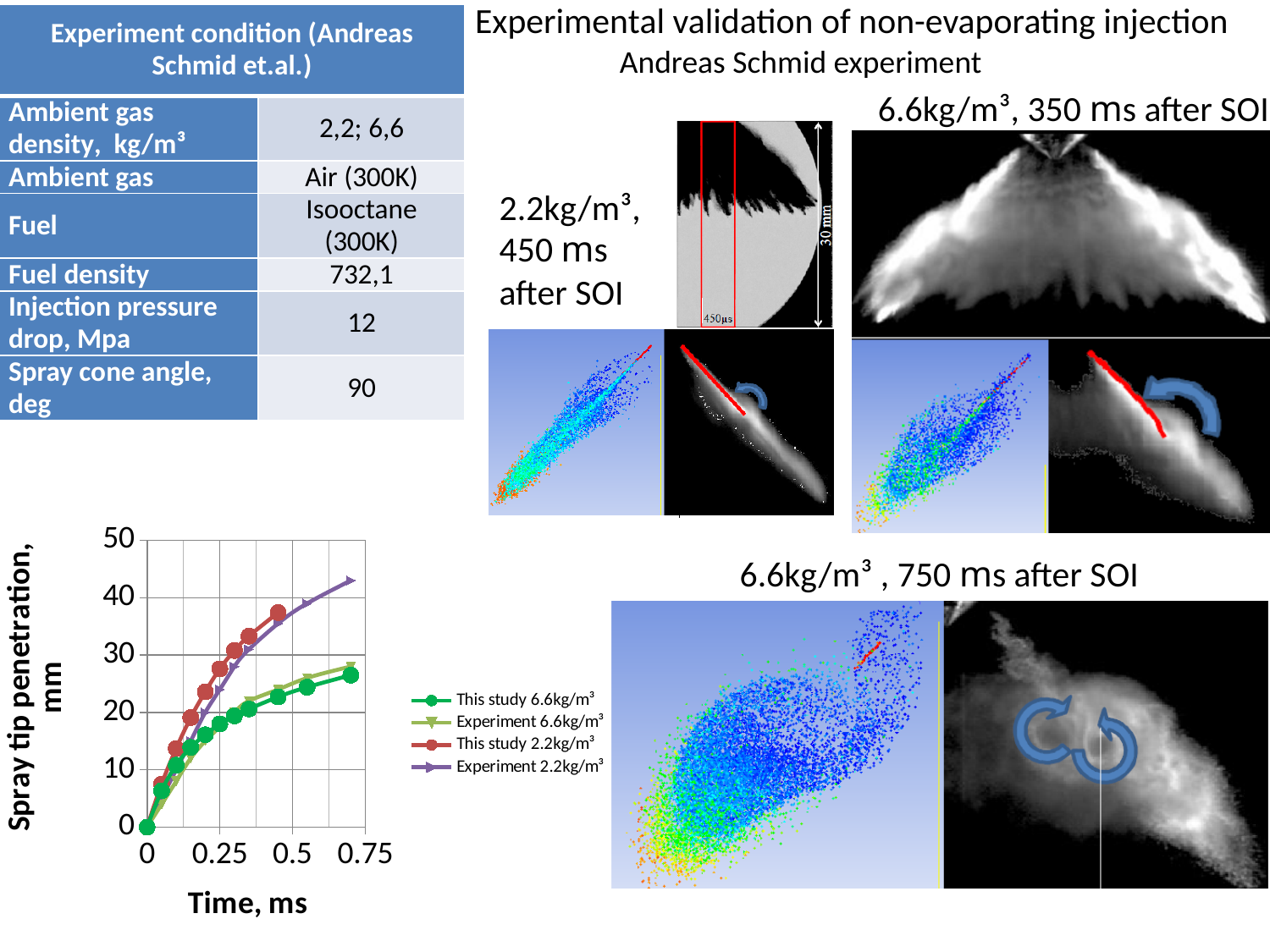
Do the spray tip penetration values rise or fall as time increases along the x axis? rise What kind of chart is shown on the slide? line chart What is the title of the chart's vertical axis? Spray tip penetration, mm How many series does the chart legend list? 4 Which series reaches the highest spray tip penetration on the chart? Experiment 2.2kg/m³ Is the value for Experiment 2.2kg/m³ at about 0.7 ms greater or less than 40? greater At about 0.7 ms, which series has the larger value: Experiment 2.2kg/m³ or This study 6.6kg/m³? Experiment 2.2kg/m³ Is the value for This study 2.2kg/m³ at about 0.45 ms greater or less than 30? greater Is the value for This study 6.6kg/m³ at about 0.7 ms greater or less than 30? less What are the four series listed in the chart legend? This study 6.6kg/m³, Experiment 6.6kg/m³, This study 2.2kg/m³, Experiment 2.2kg/m³ What is the spray tip penetration value for all series at time 0 ms? 0 At about 0.45 ms, which series has the larger value: This study 2.2kg/m³ or This study 6.6kg/m³? This study 2.2kg/m³